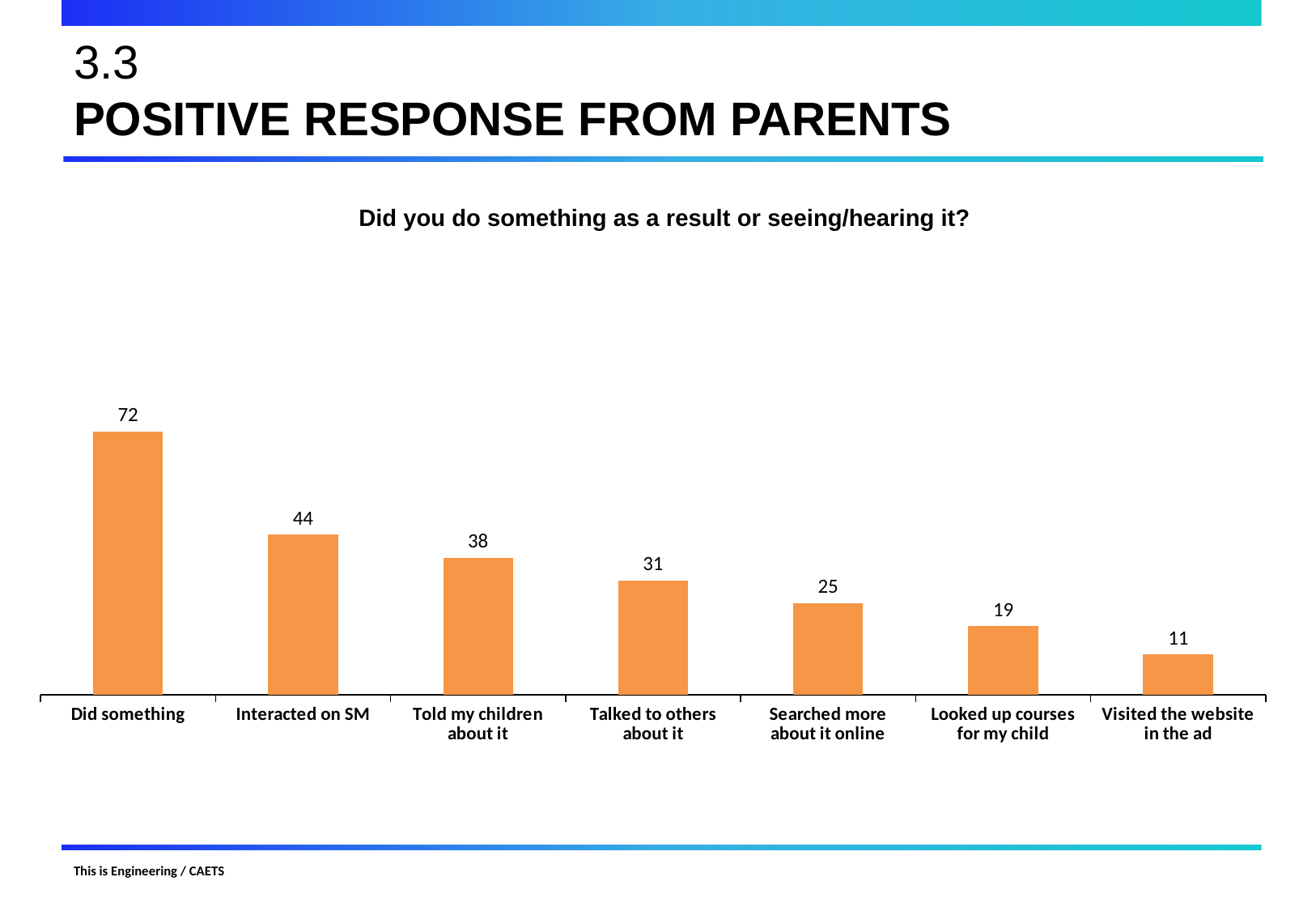
Do the values rise or fall from left to right along the x axis? Fall Which is larger, "Talked to others about it" or "Searched more about it online"? Talked to others about it What is the value for "Did something"? 72 What is the difference between "Interacted on SM" and "Told my children about it"? 6 Which category has the highest value? Did something How many categories are shown in the chart? 7 What is the title of the chart? Did you do something as a result or seeing/hearing it? What kind of chart is shown on the slide? Bar chart What is the value for "Searched more about it online"? 25 What is the difference between "Did something" and "Visited the website in the ad"? 61 What is the value for "Looked up courses for my child"? 19 Which category has the lowest value? Visited the website in the ad